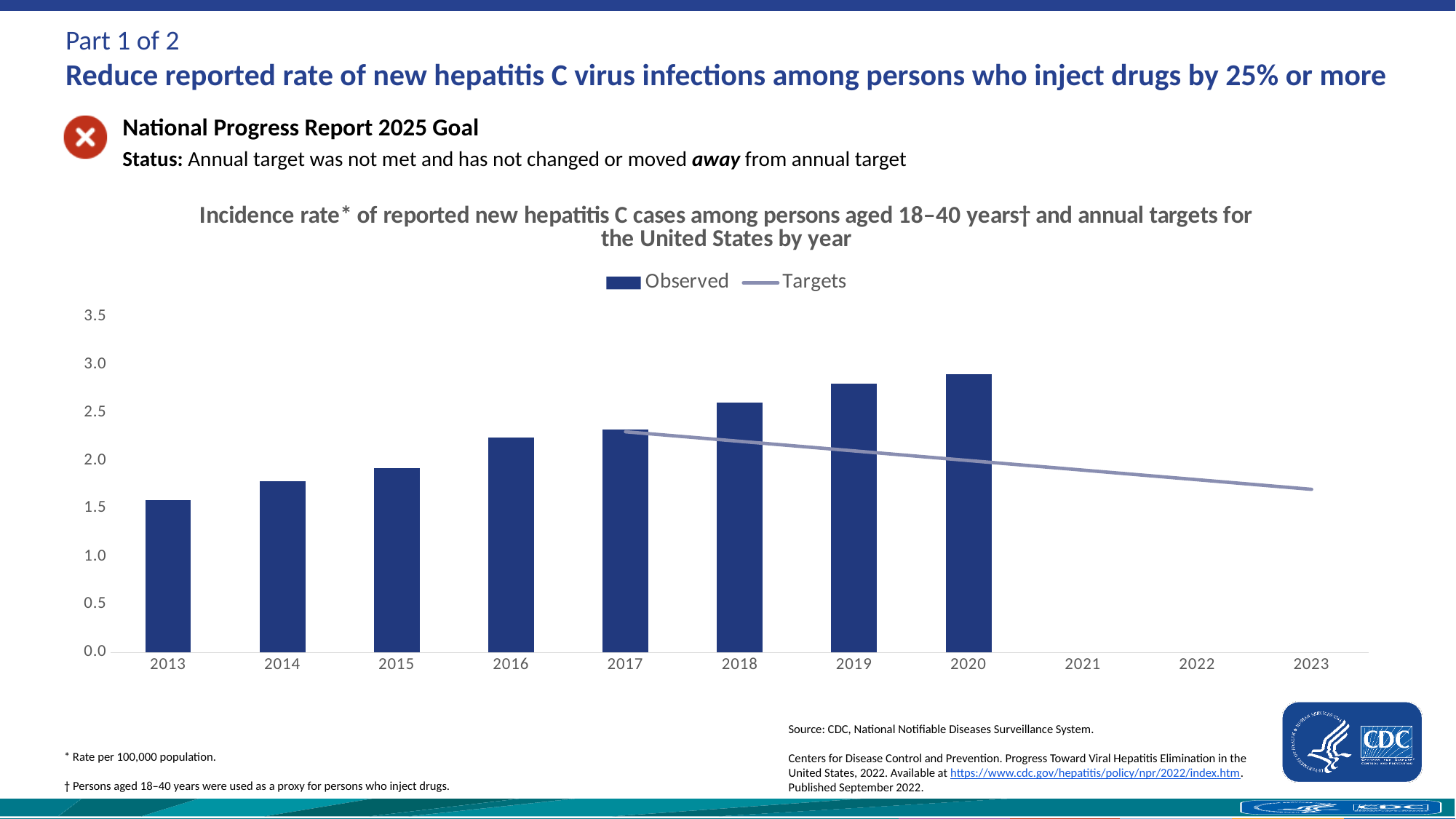
Which year has the highest Observed bar? 2020 How many years have an Observed bar plotted? 8 What kind of chart is shown on the slide? combination bar and line chart Is the Observed value for 2013 greater or less than 2.0? less Do the Observed values rise or fall from 2013 to 2020? rise What are the two series named in the legend? Observed and Targets Is the Observed value for 2014 greater or less than 2.0? less Which year has the lowest Observed bar? 2013 Is the Observed value for 2016 greater or less than 2.0? greater How many series does the legend list? 2 Which year has a higher Observed value, 2014 or 2018? 2018